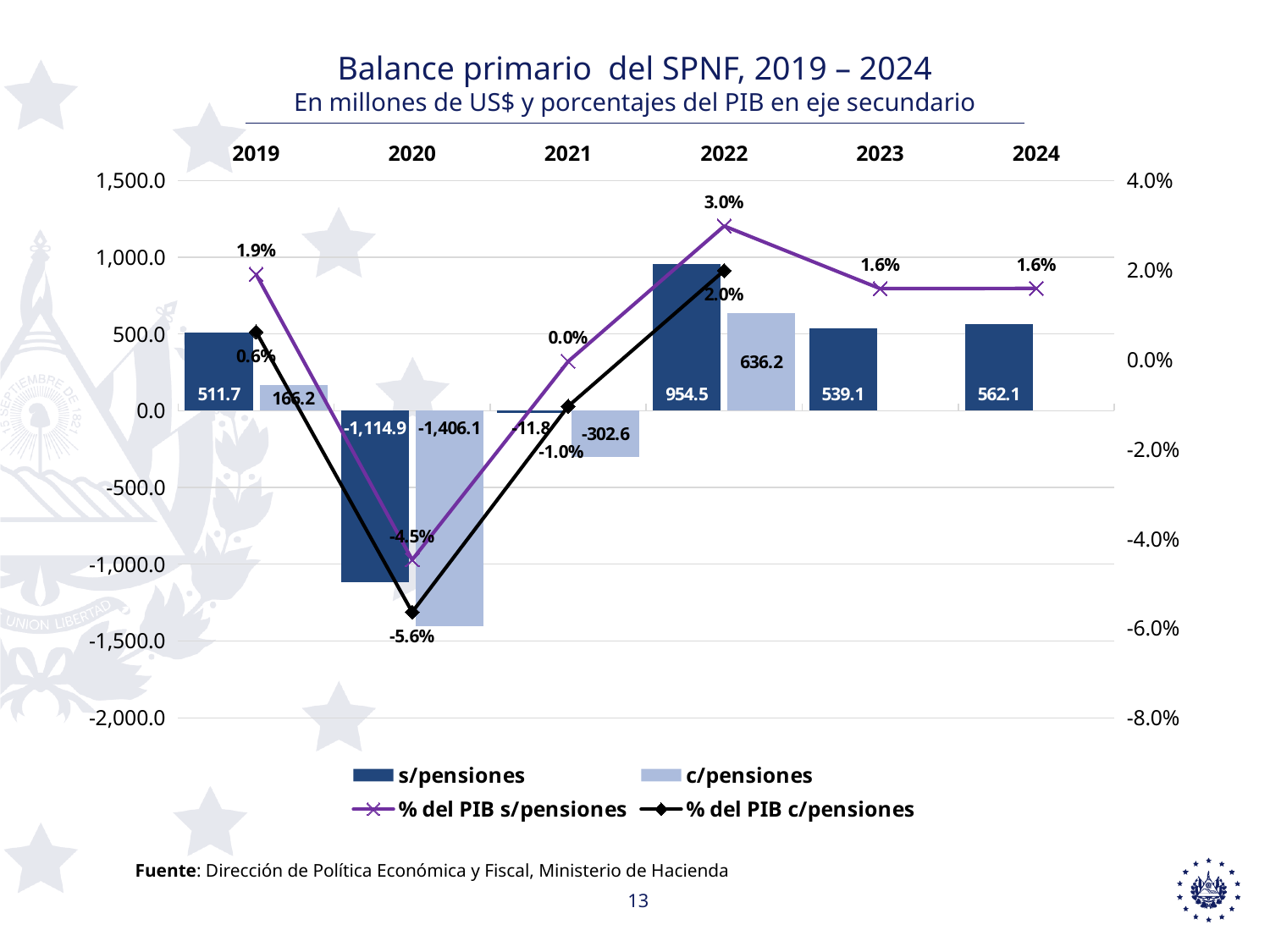
In 2019, which is larger: s/pensiones or c/pensiones? s/pensiones How many years are shown on the x axis? 6 How many series does the legend list? 4 What is the % del PIB c/pensiones value for 2020? -5.6% What kind of chart is this? Combined bar and line chart In which year is the s/pensiones bar highest? 2022 What is the % del PIB s/pensiones value for 2022? 3.0% What is the value of c/pensiones for 2020? -1,406.1 In which year is the c/pensiones bar lowest? 2020 Does the % del PIB s/pensiones line rise or fall from 2022 to 2023? Fall What is the value of s/pensiones for 2022? 954.5 What is the difference between the s/pensiones values for 2024 and 2023? 23.0